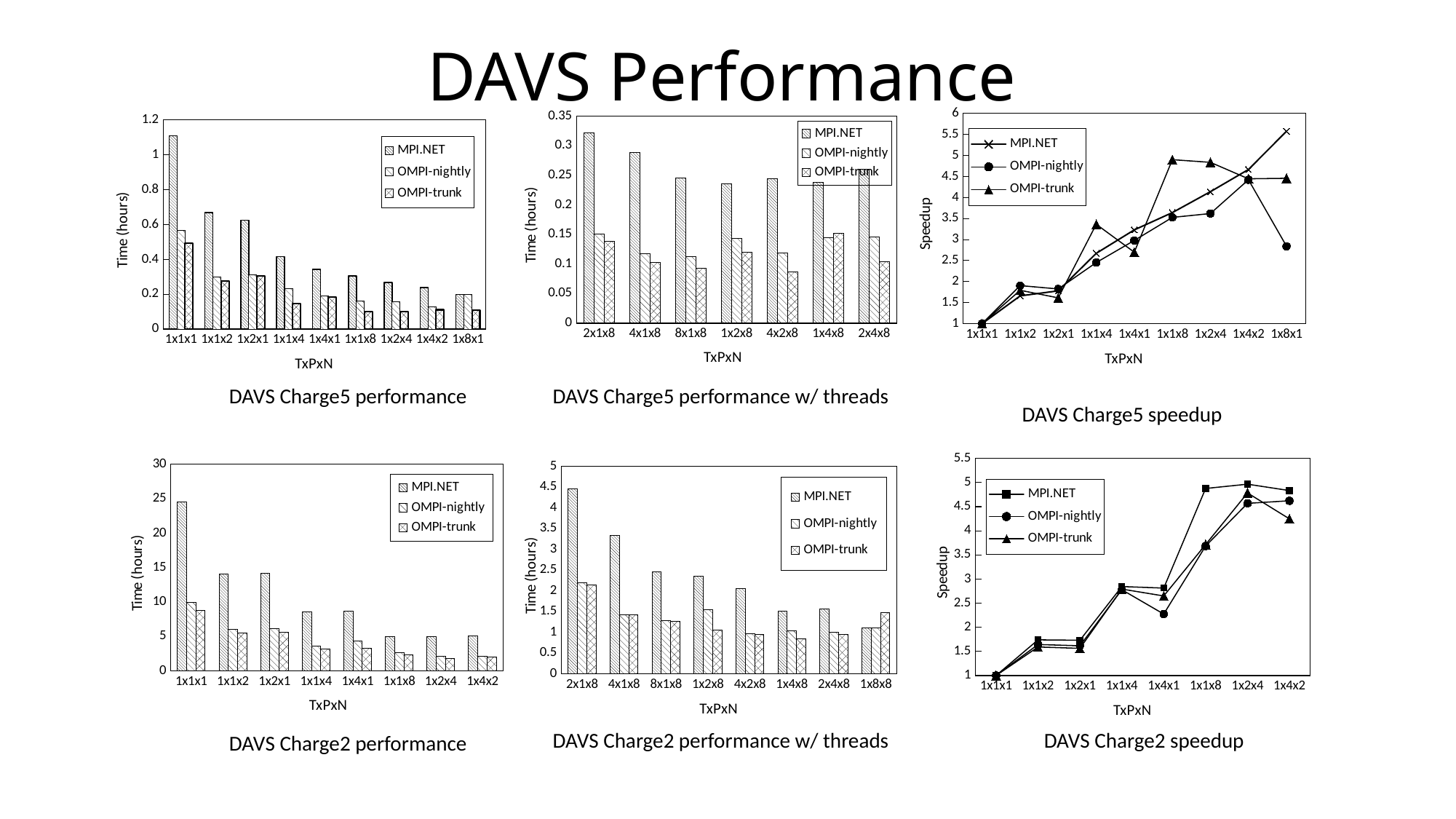
On the DAVS Charge5 performance w/ threads chart, how many TxPxN categories are shown on the x axis? 7 On the DAVS Charge5 performance chart, how many series does the legend list? 3 On the DAVS Charge2 performance chart, is the MPI.NET value for 1x1x1 greater or less than 20? greater On the DAVS Charge2 speedup chart, what kind of chart is it? line chart On the DAVS Charge5 speedup chart, which series has the highest speedup at 1x8x1? MPI.NET On the DAVS Charge5 performance chart, is the MPI.NET value for 1x1x1 greater or less than 1? greater On the DAVS Charge2 performance chart, which TxPxN category has the highest MPI.NET time? 1x1x1 On the DAVS Charge5 performance chart, what kind of chart is it? bar chart On the DAVS Charge5 performance w/ threads chart, is the MPI.NET value for 2x1x8 greater or less than 0.3? greater On the DAVS Charge5 performance chart, how many TxPxN categories are shown on the x axis? 9